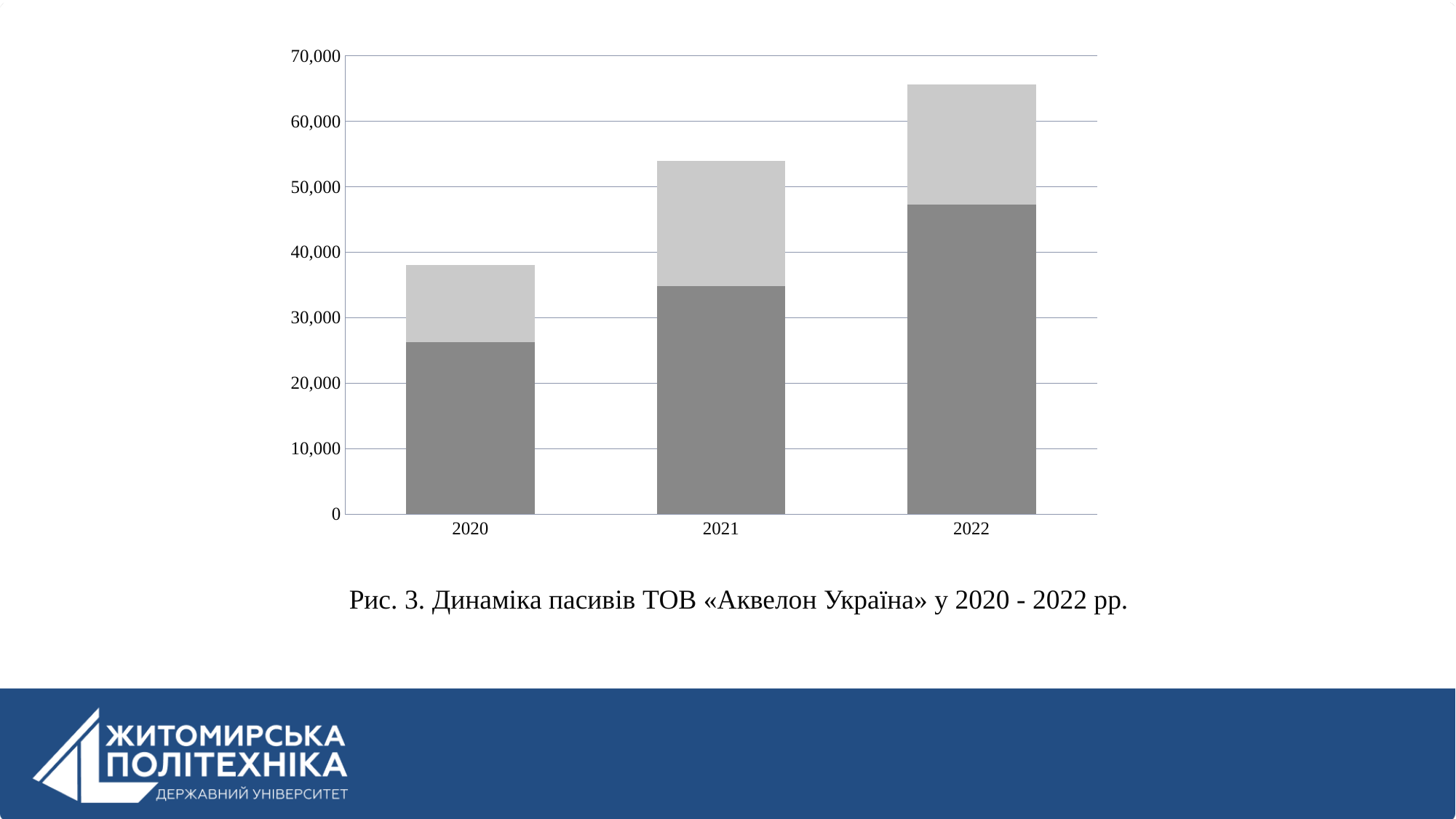
Is the dark grey segment of the 2020 bar greater or less than 20,000? greater Do the total bar heights rise or fall from 2020 to 2022? Rise Is the total height of the 2022 bar greater or less than 60,000? greater What is the caption of the figure shown on the slide? Рис. 3. Динаміка пасивів ТОВ «Аквелон Україна» у 2020 - 2022 рр. Is the total height of the 2021 bar greater or less than 50,000? greater Which is larger: the total bar for 2021 or the total bar for 2020? 2021 What kind of chart is shown on the slide? Stacked bar chart Which year has the tallest stacked bar? 2022 How many years (categories) are shown on the x axis? 3 Which year has the shortest stacked bar? 2020